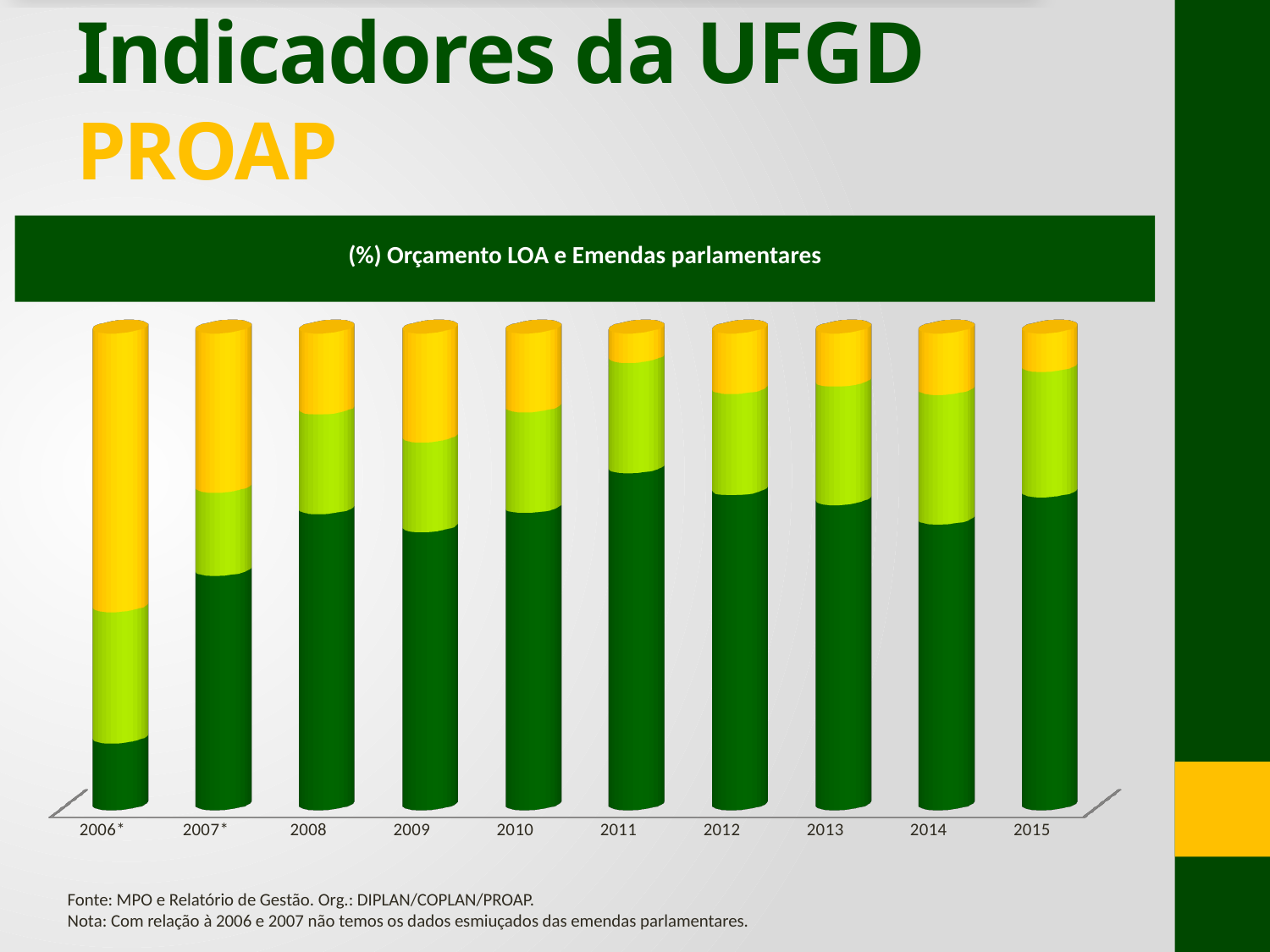
Is the yellow segment larger in 2007* or in 2008? 2007* Is the dark green segment larger in 2006* or in 2015? 2015 How many coloured segments make up each bar in the chart? 3 Which year has the smallest yellow segment? 2011 Which year has the largest dark green segment? 2011 How many years are shown along the x axis of the chart? 10 Which year has the largest yellow segment? 2006* Which two years on the x axis are marked with an asterisk? 2006* and 2007* What kind of chart is shown on the slide? stacked bar chart What is the title of the chart? (%) Orçamento LOA e Emendas parlamentares Which year has the smallest dark green segment? 2006* Does the dark green segment rise or fall from 2006* to 2011? rise